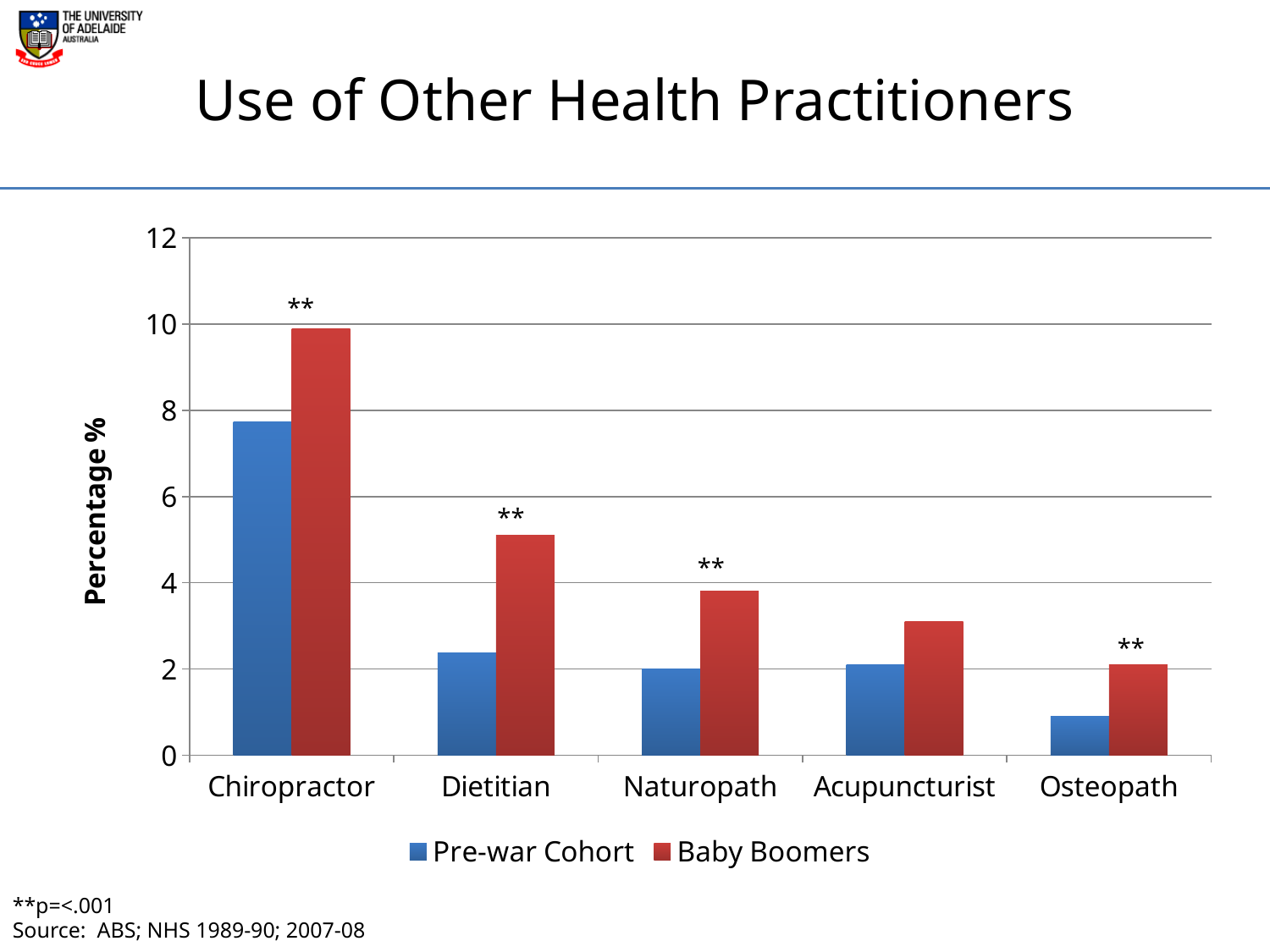
How many health practitioner categories are shown on the x axis? 5 Is the Baby Boomers value for Chiropractor greater or less than 8? greater Which category has the lowest value for the Pre-war Cohort? Osteopath Is the Baby Boomers value for Acupuncturist greater or less than 4? less Which category has the highest value for Baby Boomers? Chiropractor Is the Pre-war Cohort value for Osteopath greater or less than 2? less Which is larger for Baby Boomers: Dietitian or Naturopath? Dietitian What kind of chart is shown on the slide? bar chart How many series does the legend list? 2 What is the label on the vertical axis? Percentage %